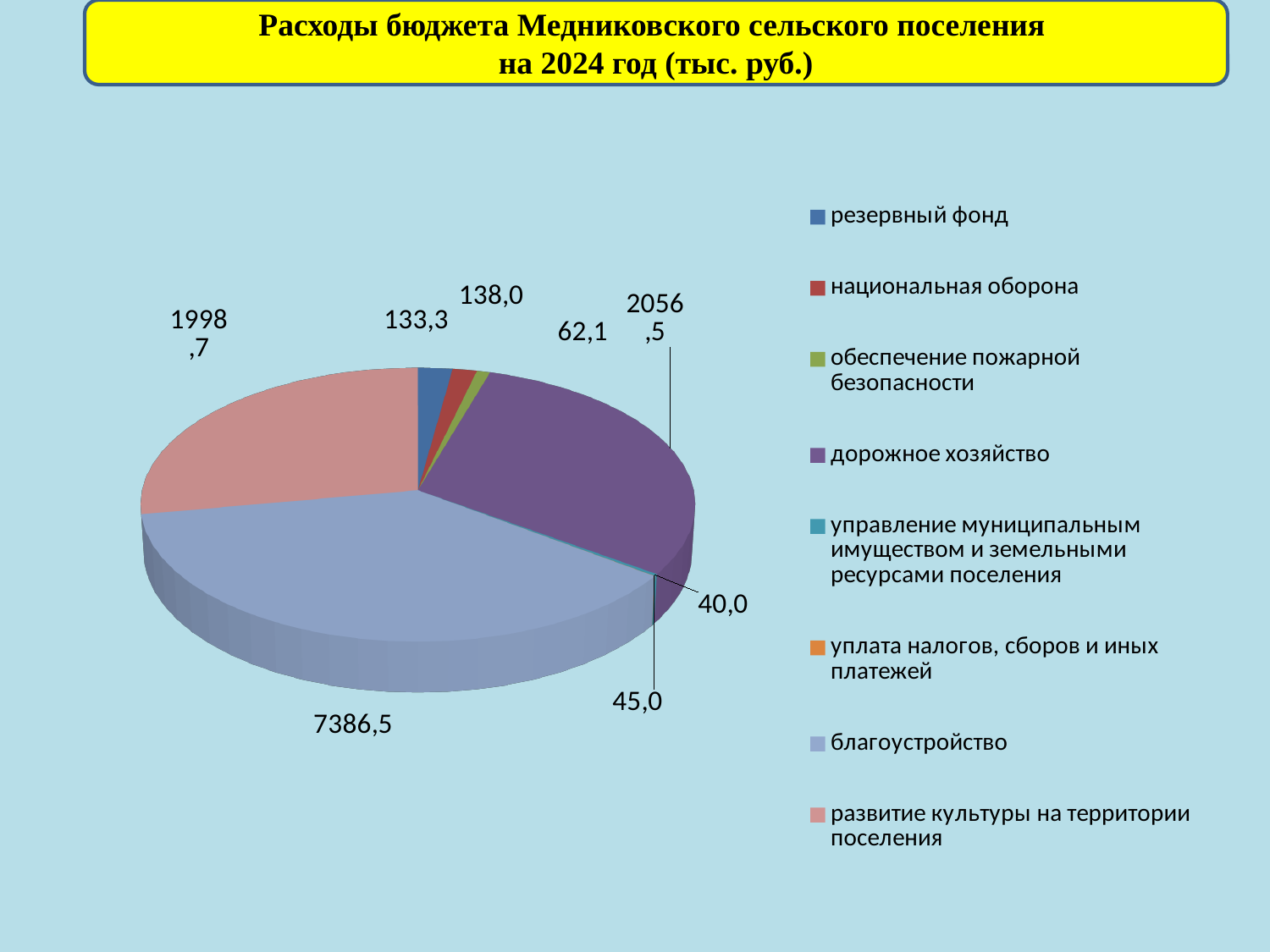
What is the value for благоустройство? 7386,5 What is the title of the chart? Расходы бюджета Медниковского сельского поселения на 2024 год (тыс. руб.) Which category has the largest value? благоустройство How many categories does the legend list? 8 Which is larger: the value for уплата налогов, сборов и иных платежей or the value for обеспечение пожарной безопасности? обеспечение пожарной безопасности What is the difference between the values for дорожное хозяйство and развитие культуры на территории поселения? 57,8 What is the value for управление муниципальным имуществом и земельными ресурсами поселения? 40,0 What is the value for национальная оборона? 138,0 What is the value for развитие культуры на территории поселения? 1998,7 What is the value for дорожное хозяйство? 2056,5 What type of chart is shown on the slide? Pie chart Which category has the smallest value? управление муниципальным имуществом и земельными ресурсами поселения